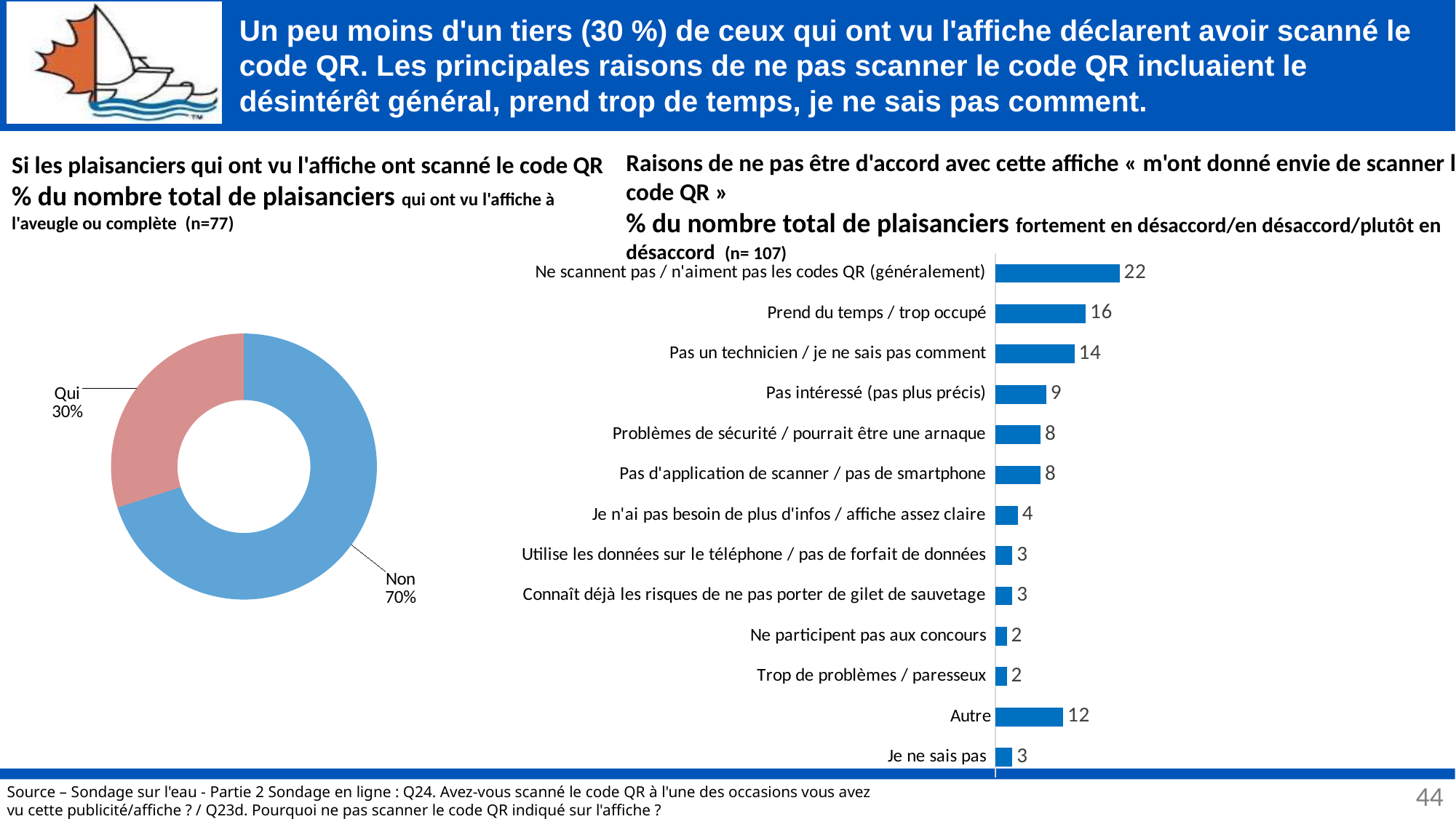
In the bar chart on the right, which category has the highest value? Ne scannent pas / n'aiment pas les codes QR (généralement) In the pie chart on the left, what percentage of boaters answered "Non"? 70% In the bar chart on the right, what is the value for "Autre"? 12 What kind of chart is the chart on the left of the slide? Pie chart (doughnut) In the bar chart on the right, what is the value for "Je ne sais pas"? 3 What kind of chart is the chart on the right of the slide? Bar chart How many categories are shown in the bar chart on the right? 13 In the bar chart on the right, what is the difference between "Ne scannent pas / n'aiment pas les codes QR (généralement)" and "Pas un technicien / je ne sais pas comment"? 8 In the bar chart on the right, which is larger, "Pas intéressé (pas plus précis)" or "Problèmes de sécurité / pourrait être une arnaque"? Pas intéressé (pas plus précis) In the bar chart on the right, what is the value for "Prend du temps / trop occupé"? 16